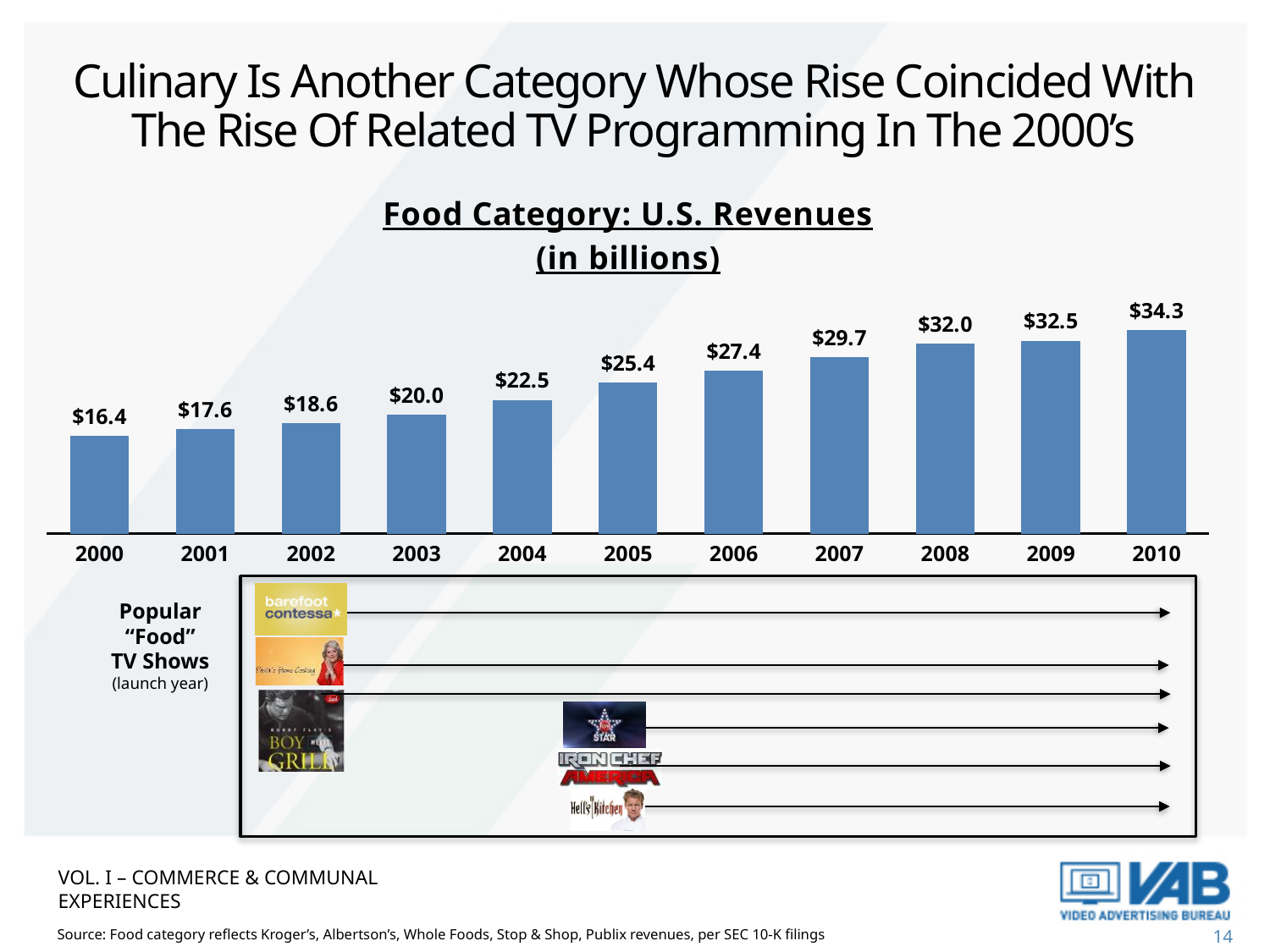
Which year has the highest food category U.S. revenue? 2010 Do food category revenues rise or fall from 2000 to 2010? Rise Which year has the lowest food category U.S. revenue? 2000 What is the difference between the 2010 and 2000 food category revenues? $17.9 What is the food category U.S. revenue for 2008? $32.0 What is the difference between the 2007 and 2006 food category revenues? $2.3 What is the title of the chart on the slide? Food Category: U.S. Revenues (in billions) Which year has the larger food category revenue, 2003 or 2004? 2004 What kind of chart is used to show Food Category: U.S. Revenues? Bar chart What is the food category U.S. revenue for 2005? $25.4 What is the food category U.S. revenue for 2000? $16.4 How many years are shown in the Food Category: U.S. Revenues chart? 11